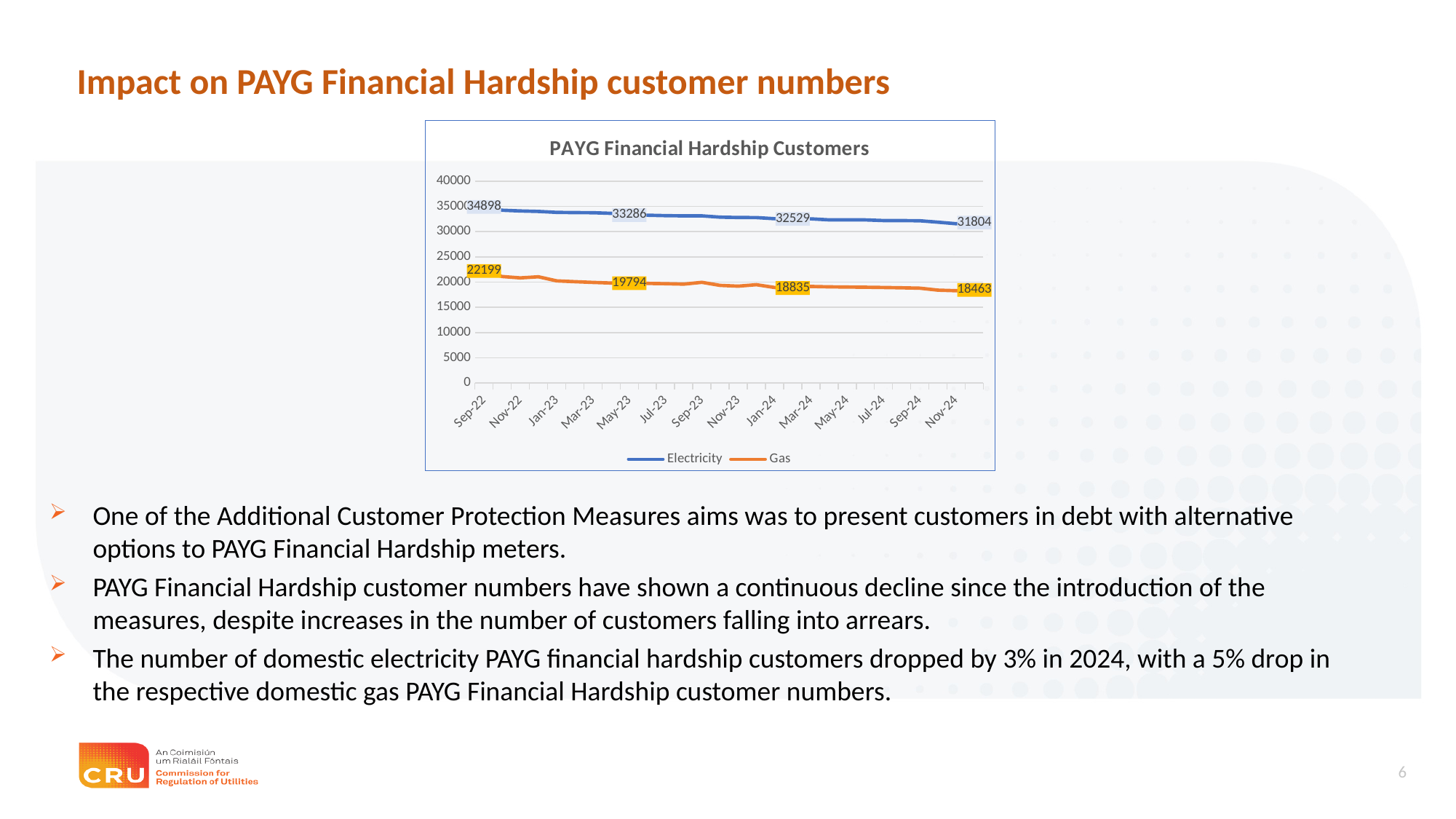
Which series has higher values throughout the chart, Electricity or Gas? Electricity What is the difference between the Gas values labelled at Sep-22 and Nov-24? 3736 Do the Gas values rise or fall from Sep-22 to Nov-24? Fall What is the Gas value labelled at Nov-24? 18463 What is the difference between the Electricity values labelled at Sep-22 and Nov-24? 3094 What type of chart is shown on the slide? Line chart What is the Electricity value labelled at Sep-22? 34898 What is the Gas value labelled at May-23? 19794 What is the Electricity value labelled at Jan-24? 32529 Is the Gas value at Nov-22 greater or less than 25000? less How many series does the chart legend list? 2 What is the title of the chart? PAYG Financial Hardship Customers